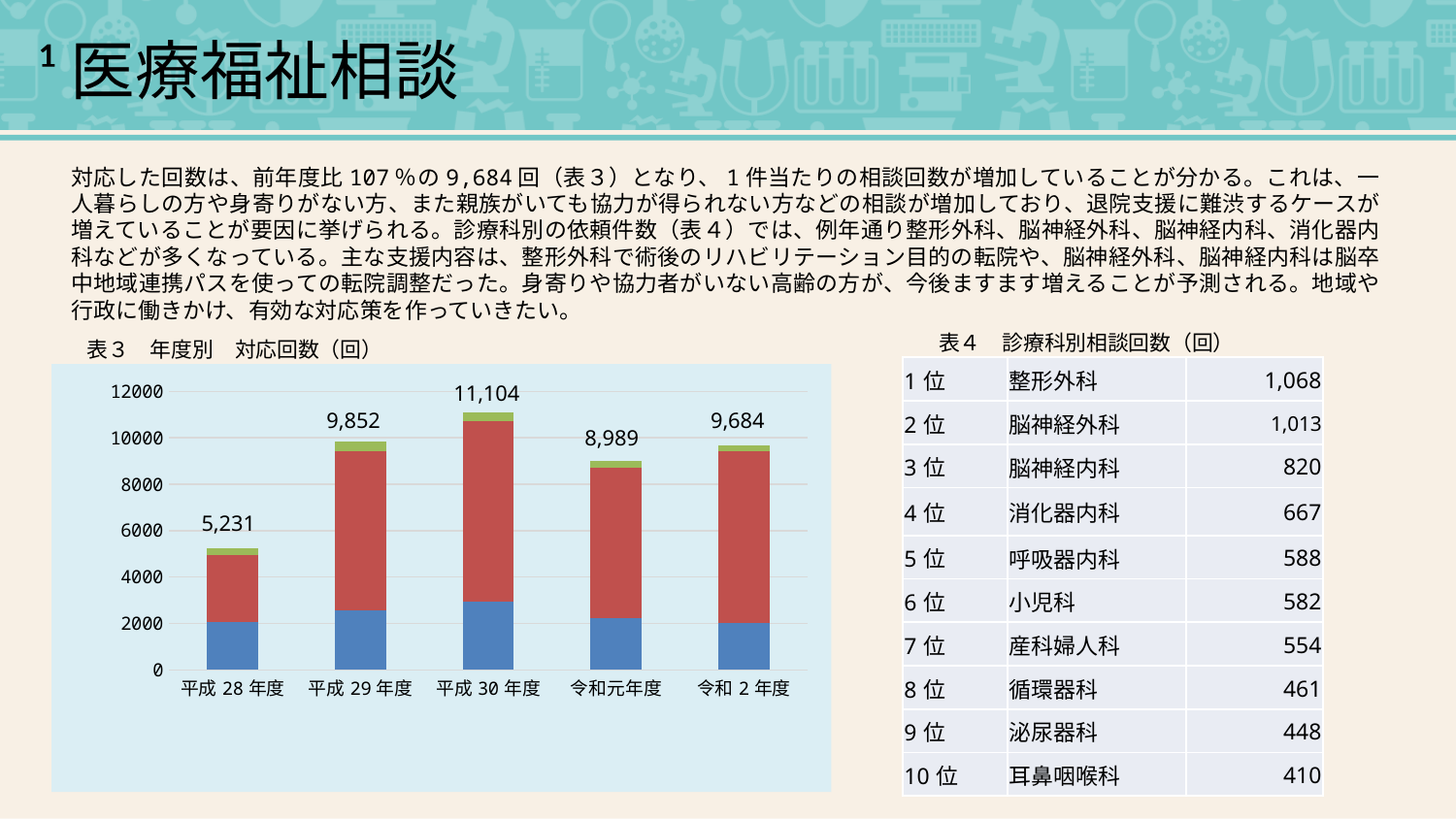
What is the total value shown for 平成28年度 in the chart? 5,231 What is the difference between the totals for 令和2年度 and 平成28年度? 4,453 What is the difference between the totals for 平成30年度 and 令和元年度? 2,115 How many fiscal years are shown on the x axis of the chart? 5 What is the total value shown for 令和元年度 in the chart? 8,989 What is the total value shown for 令和2年度 in the chart? 9,684 What is the total value shown for 平成30年度 in the chart 表３ 年度別 対応回数（回）? 11,104 Is the total for 令和元年度 greater or less than 10000? less Which fiscal year has the lowest total in the chart? 平成28年度 What kind of chart is 表３ 年度別 対応回数（回）? stacked bar chart Which is larger, the total for 平成29年度 or the total for 令和2年度? 平成29年度 Which fiscal year has the highest total in the chart? 平成30年度